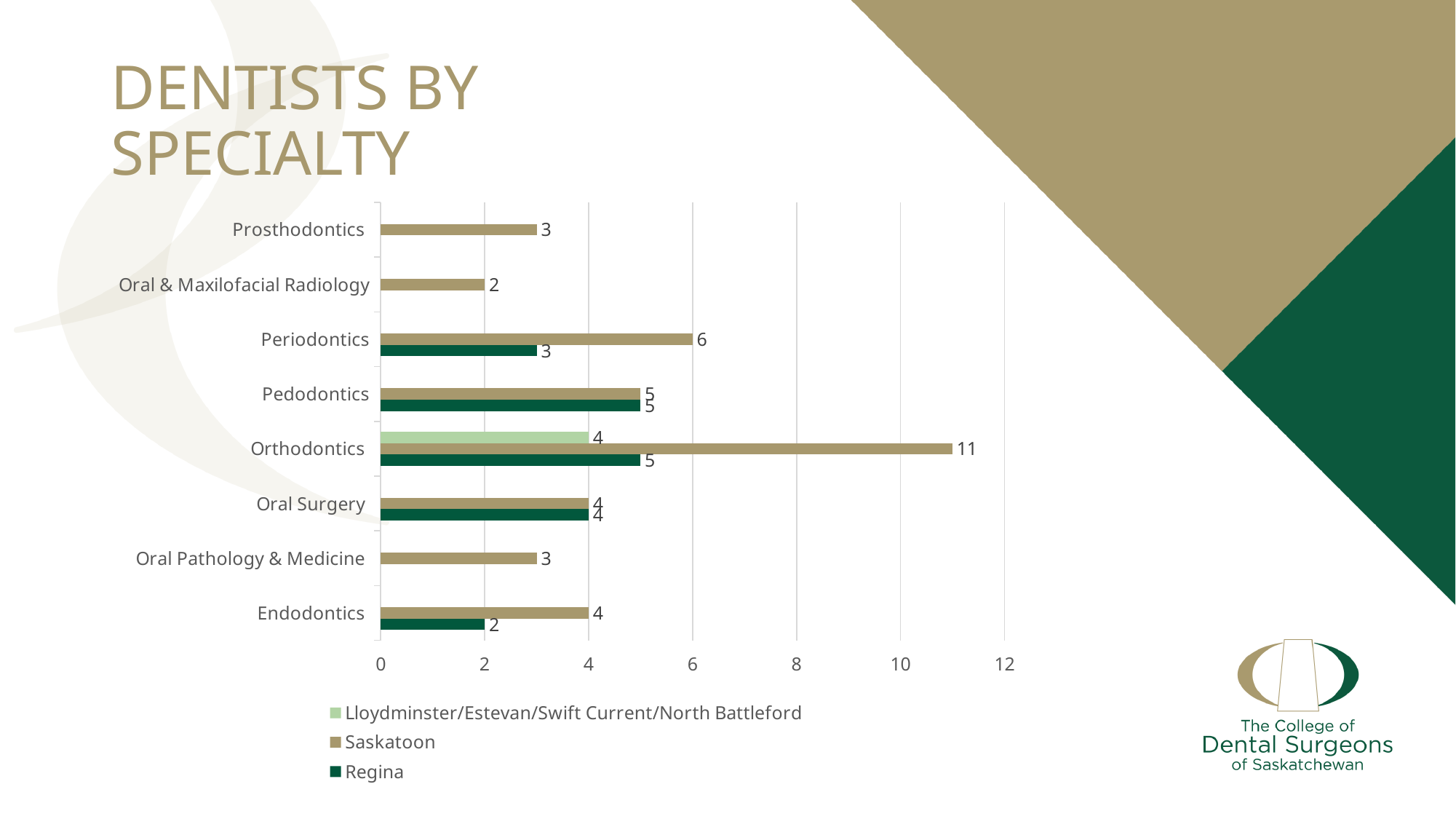
What is the Lloydminster/Estevan/Swift Current/North Battleford value for Orthodontics? 4 Which specialty has the lowest Saskatoon value? Oral & Maxilofacial Radiology Which specialty has the highest Saskatoon value? Orthodontics What is the Regina value for Endodontics? 2 What is the Saskatoon value for Orthodontics? 11 What kind of chart is shown on the slide? Bar chart What is the difference between the Saskatoon and Regina values for Periodontics? 3 Is the Saskatoon value for Orthodontics greater or less than 10? greater Which is larger for Endodontics, the Saskatoon value or the Regina value? Saskatoon What is the Saskatoon value for Periodontics? 6 How many series does the legend list? 3 How many specialties are listed on the chart? 8